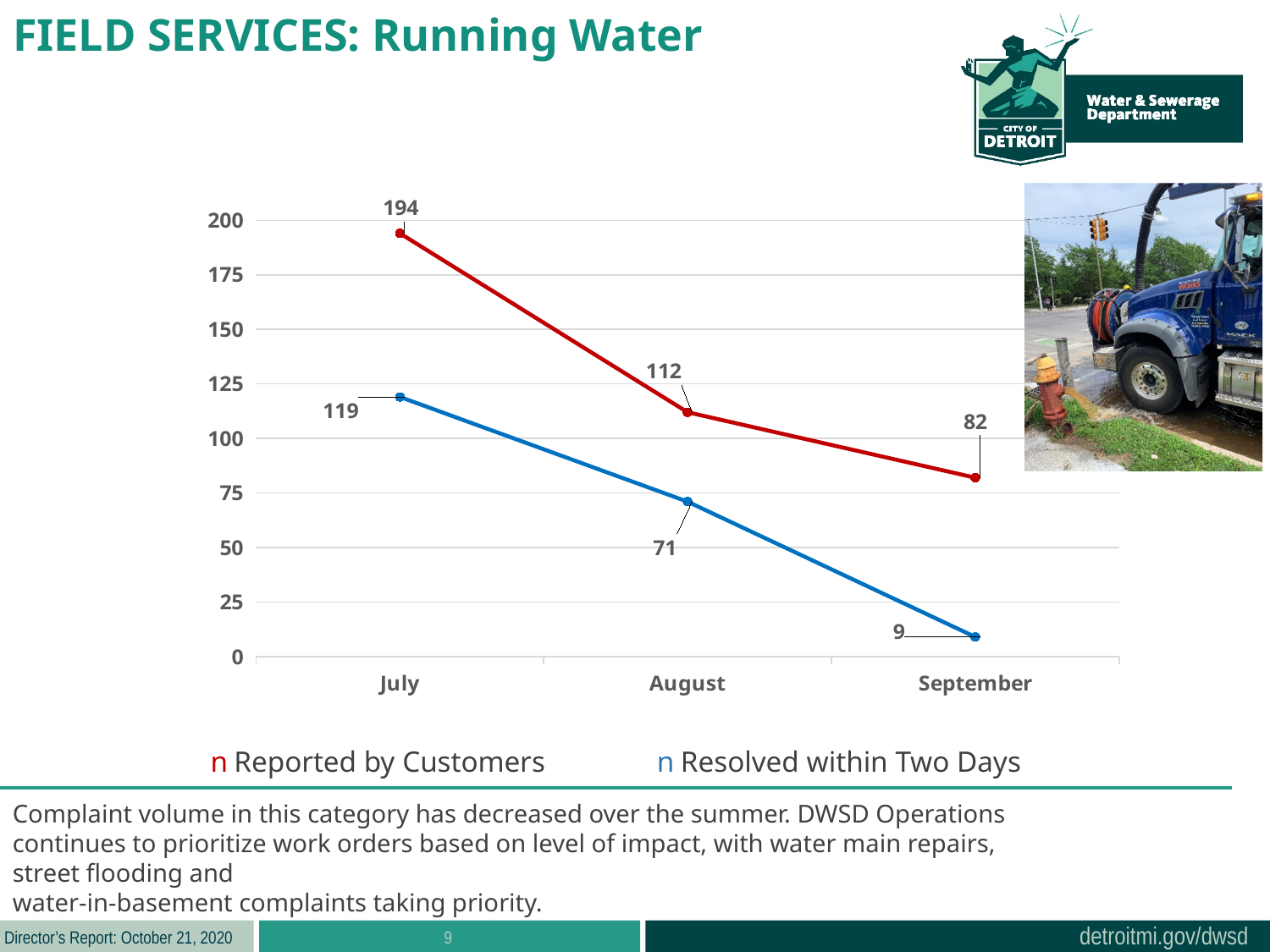
In which month is the Resolved within Two Days value lowest? September In which month is the Reported by Customers value highest? July Do the Reported by Customers values rise or fall from July to September? Fall What is the value for Resolved within Two Days in September? 9 What is the value for Reported by Customers in September? 82 Which is larger in July: Reported by Customers or Resolved within Two Days? Reported by Customers What is the difference between Reported by Customers and Resolved within Two Days in August? 41 How many series does the legend list? 2 What is the value for Reported by Customers in July? 194 What kind of chart is shown on the slide? Line chart How many months are shown on the x axis? 3 What is the value for Resolved within Two Days in August? 71